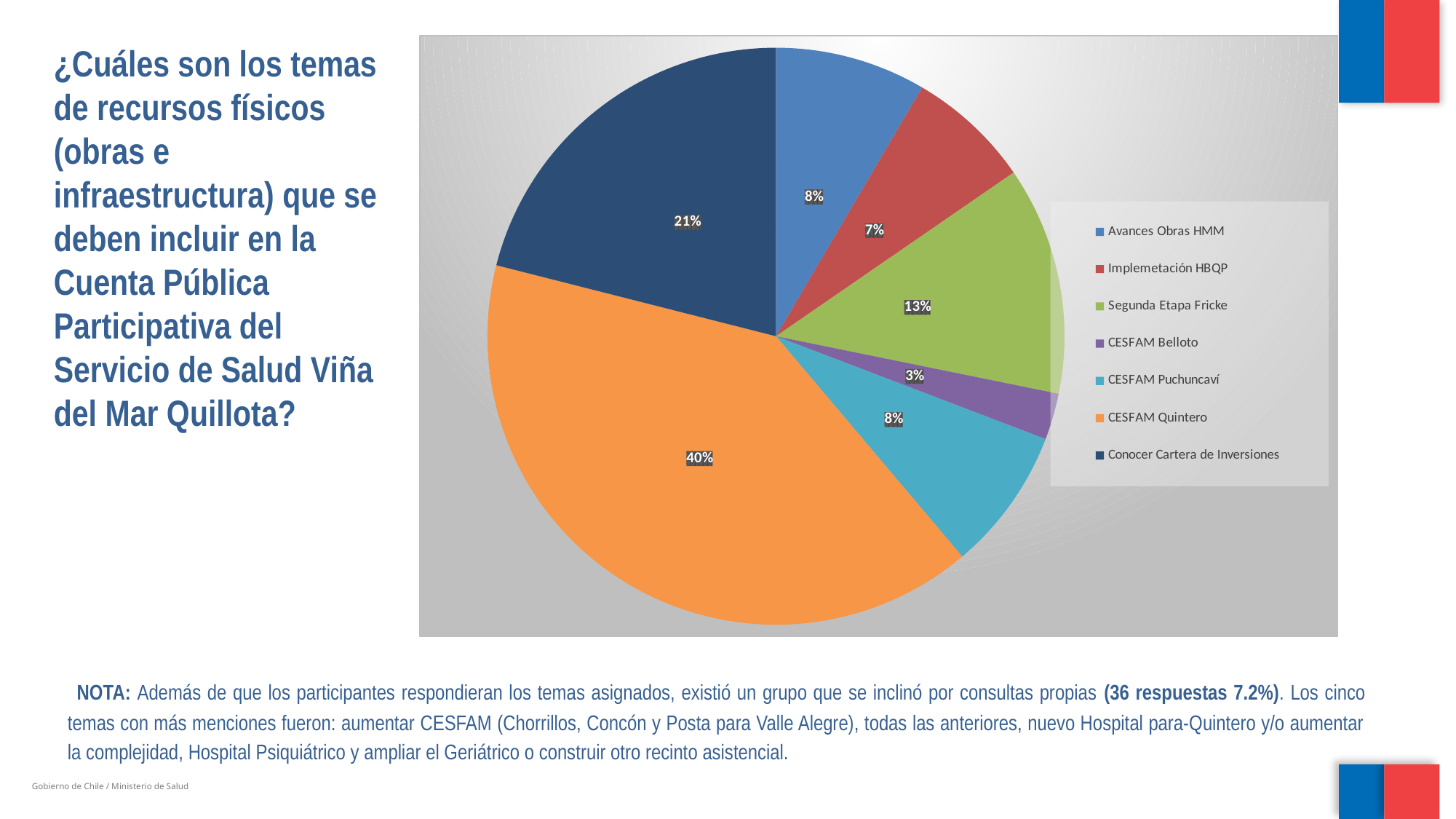
What is the difference between the shares of CESFAM Quintero and Conocer Cartera de Inversiones? 19% What share of the pie does CESFAM Quintero have? 40% Which category has the smallest slice of the pie? CESFAM Belloto Which is larger, the share for Segunda Etapa Fricke or the share for Implemetación HBQP? Segunda Etapa Fricke What share of the pie does CESFAM Belloto have? 3% What kind of chart is shown on the slide? pie chart How many categories does the pie chart have? 7 What share of the pie does Conocer Cartera de Inversiones have? 21% Which category has the largest slice of the pie? CESFAM Quintero What colour is the slice for CESFAM Quintero? orange